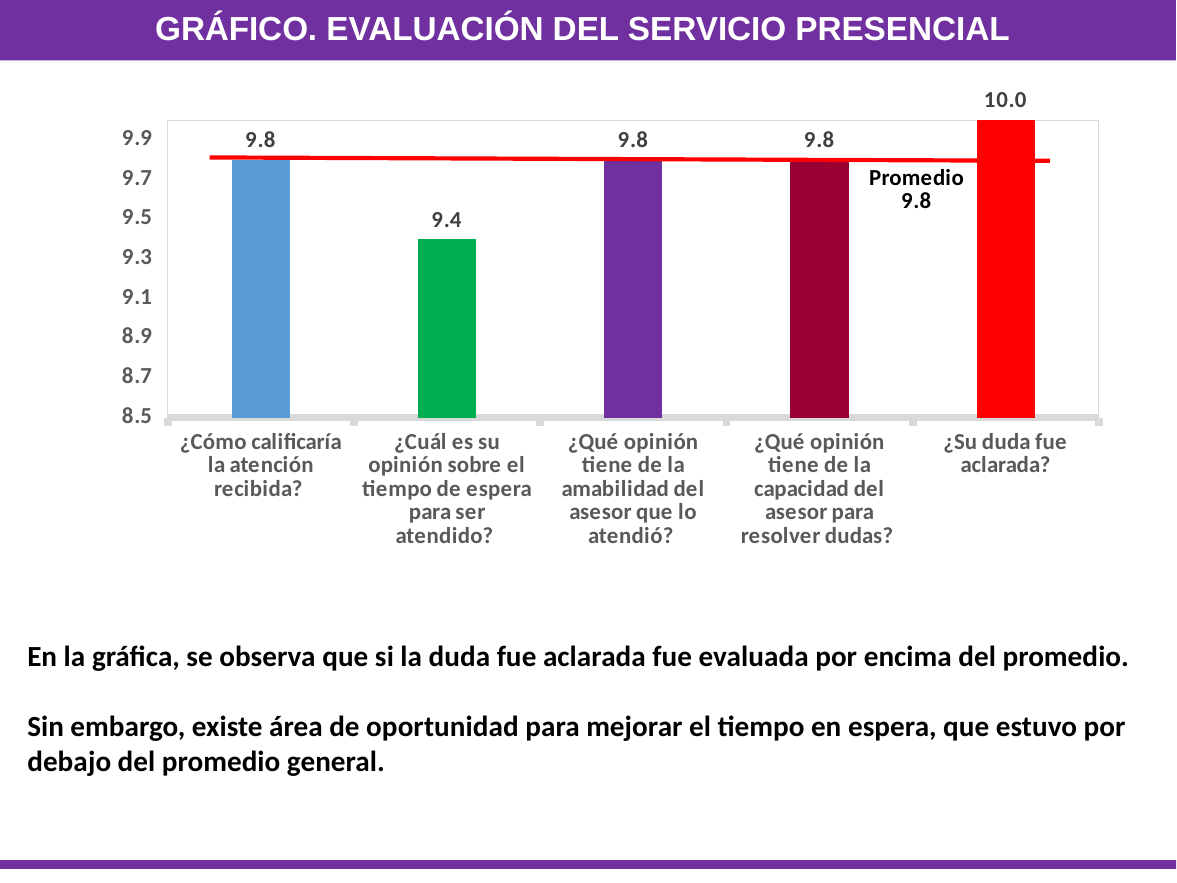
Which category has the highest value? ¿Su duda fue aclarada? What is the difference between the value for '¿Su duda fue aclarada?' and the value for '¿Cuál es su opinión sobre el tiempo de espera para ser atendido?'? 0.6 Which is larger: the value for '¿Qué opinión tiene de la amabilidad del asesor que lo atendió?' or the value for '¿Cuál es su opinión sobre el tiempo de espera para ser atendido?'? ¿Qué opinión tiene de la amabilidad del asesor que lo atendió? What is the value for '¿Cuál es su opinión sobre el tiempo de espera para ser atendido?'? 9.4 What is the title of the chart? GRÁFICO. EVALUACIÓN DEL SERVICIO PRESENCIAL Which category has the lowest value? ¿Cuál es su opinión sobre el tiempo de espera para ser atendido? What kind of chart is this? bar chart Is the value for '¿Cuál es su opinión sobre el tiempo de espera para ser atendido?' greater or less than 9.5? less What is the value of the 'Promedio' line shown on the chart? 9.8 What is the value for '¿Su duda fue aclarada?'? 10.0 What is the value for '¿Cómo calificaría la atención recibida?'? 9.8 How many categories are shown on the x axis? 5